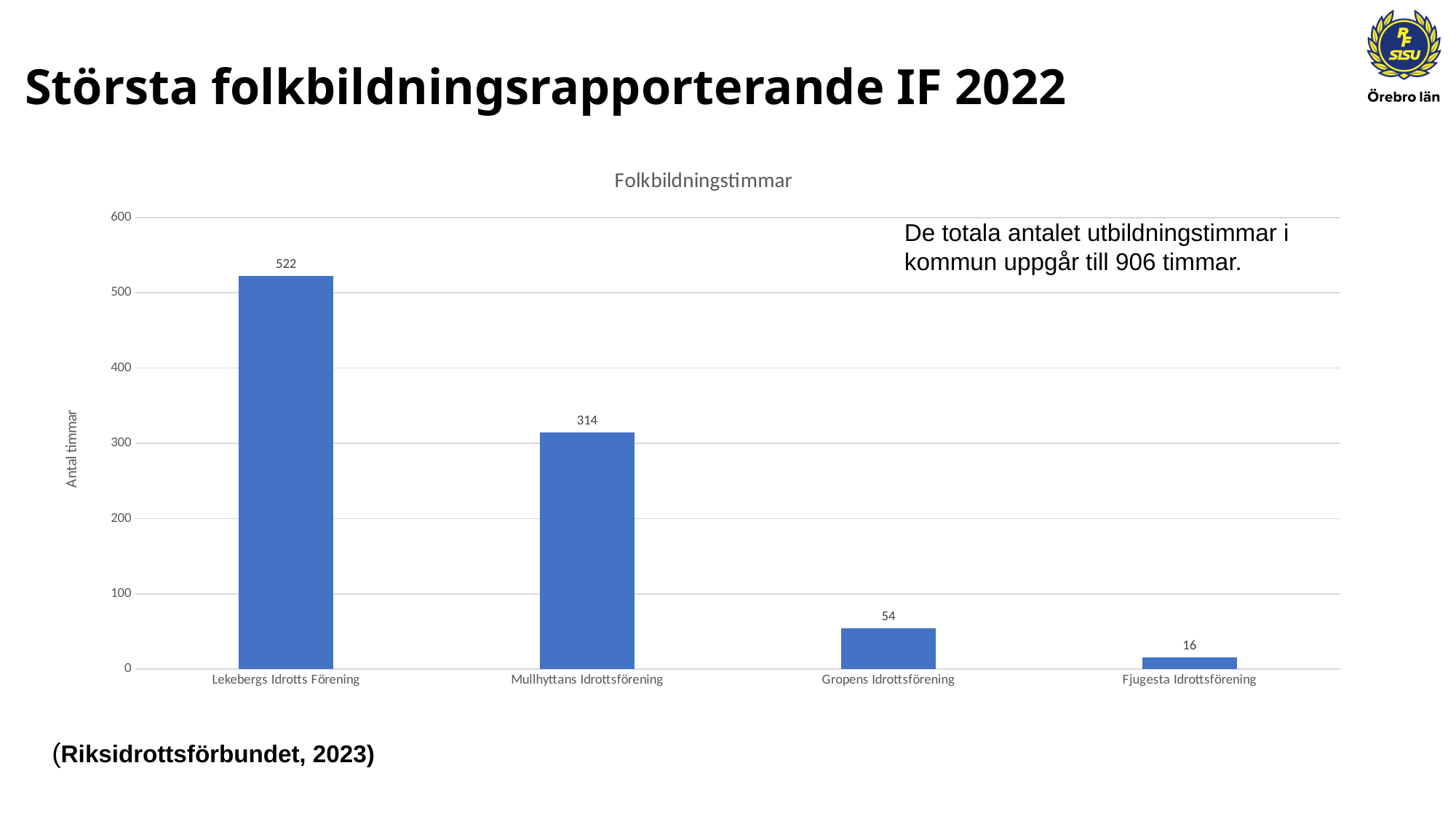
How many categories are shown on the x axis? 4 What is the title of the chart? Folkbildningstimmar What is the value for Lekebergs Idrotts Förening? 522 What is the difference between the values for Lekebergs Idrotts Förening and Mullhyttans Idrottsförening? 208 Which is larger, the value for Gropens Idrottsförening or Fjugesta Idrottsförening? Gropens Idrottsförening Is the value for Mullhyttans Idrottsförening greater or less than 300? greater What is the value for Gropens Idrottsförening? 54 Which category has the lowest value? Fjugesta Idrottsförening What is the value for Fjugesta Idrottsförening? 16 What kind of chart is shown on the slide? bar chart What is the value for Mullhyttans Idrottsförening? 314 Which category has the highest value? Lekebergs Idrotts Förening